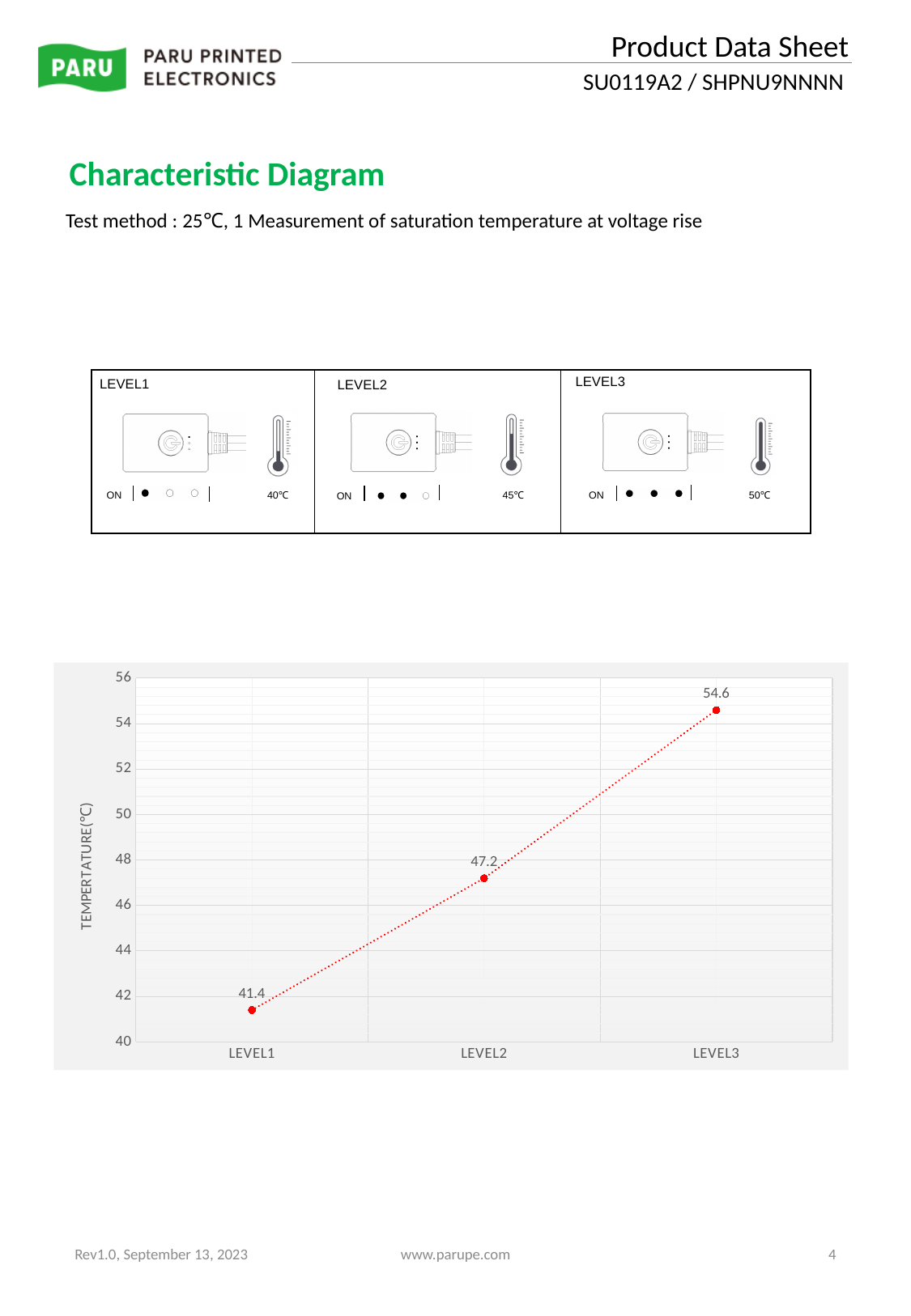
Which has a higher plotted temperature, LEVEL2 or LEVEL3? LEVEL3 What is the temperature value plotted for LEVEL1? 41.4 What is the difference between the plotted temperatures for LEVEL2 and LEVEL1? 5.8 What is the temperature value plotted for LEVEL2? 47.2 What is the temperature value plotted for LEVEL3? 54.6 Do the plotted temperatures rise or fall from LEVEL1 to LEVEL3? rise What is the label of the vertical axis of the chart? TEMPERTATURE(℃) How many data points are plotted on the chart? 3 What is the difference between the plotted temperatures for LEVEL3 and LEVEL1? 13.2 Which level has the lowest plotted temperature? LEVEL1 Which level has the highest plotted temperature? LEVEL3 Is the plotted value for LEVEL2 greater or less than 46? greater